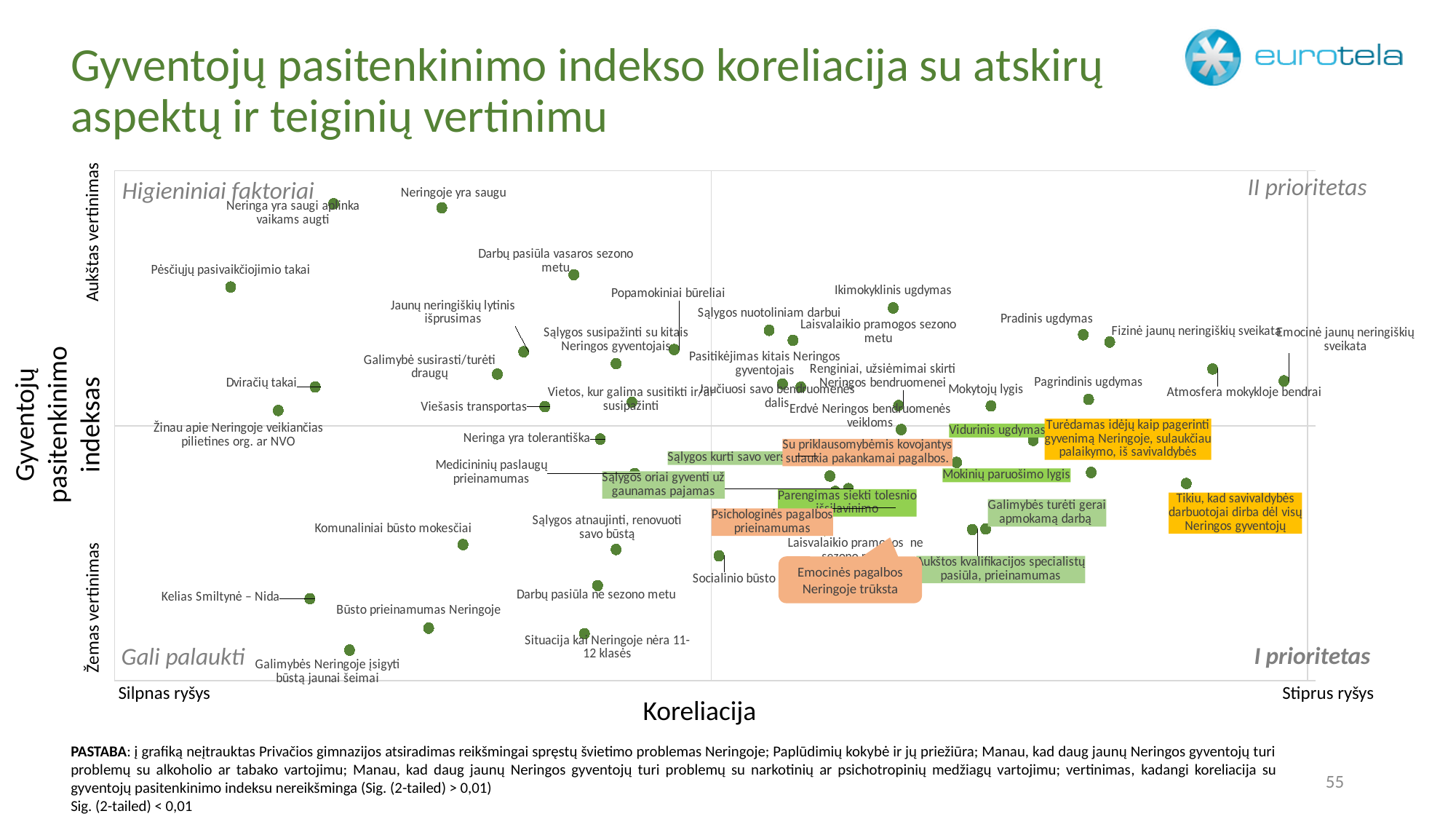
Which is plotted higher on the satisfaction index axis, "Ikimokyklinis ugdymas" or "Socialinio būsto"? Ikimokyklinis ugdymas Which has the stronger correlation (further right), "Tikiu, kad savivaldybės darbuotojai dirba dėl visų Neringos gyventojų" or "Komunaliniai būsto mokesčiai"? Tikiu, kad savivaldybės darbuotojai dirba dėl visų Neringos gyventojų What is the title of the horizontal axis of the chart? Koreliacija Which has the stronger correlation (further right), "Pradinis ugdymas" or "Dviračių takai"? Pradinis ugdymas What label appears in the top-left quadrant of the chart? Higieniniai faktoriai Which point is plotted furthest to the left, i.e. has the weakest correlation? Pėsčiųjų pasivaikščiojimo takai Which point is plotted lowest on the satisfaction index (vertical) axis? Galimybės Neringoje įsigyti būstą jaunai šeimai Which point is plotted furthest to the right, i.e. has the strongest correlation? Emocinė jaunų neringiškių sveikata What kind of chart is shown on the slide? Scatter plot